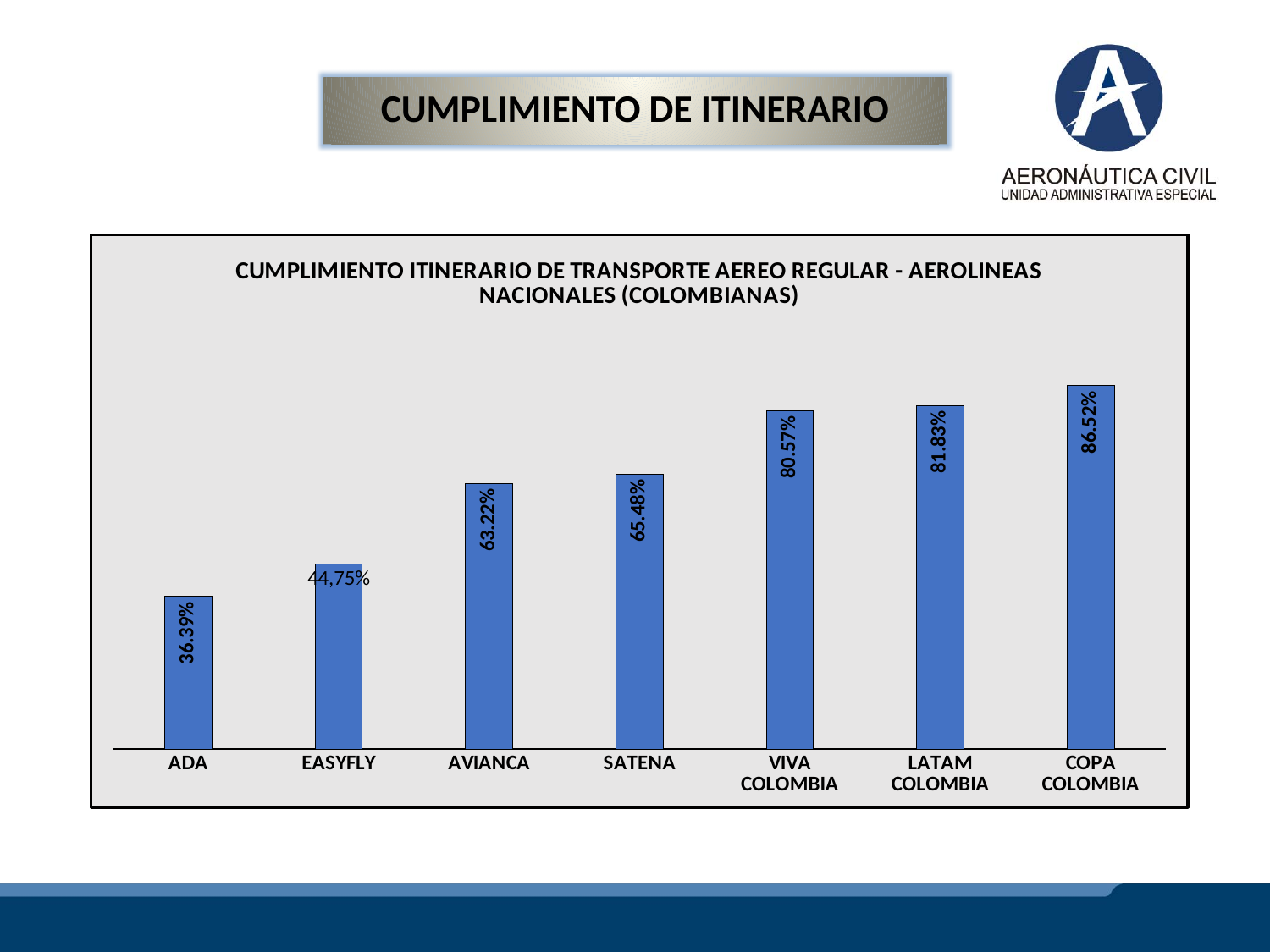
What is the value for ADA? 36.39% What kind of chart is shown? Bar chart Which airline has the highest value? COPA COLOMBIA Do the values rise or fall from left to right along the x axis? Rise What is the value for EASYFLY? 44,75% What is the value for SATENA? 65.48% What is the value for LATAM COLOMBIA? 81.83% Which airline has the lowest value? ADA What is the difference between the values for COPA COLOMBIA and ADA? 50.13% Which is larger, the value for VIVA COLOMBIA or the value for LATAM COLOMBIA? LATAM COLOMBIA How many airlines are shown in the chart? 7 What is the difference between the values for SATENA and AVIANCA? 2.26%